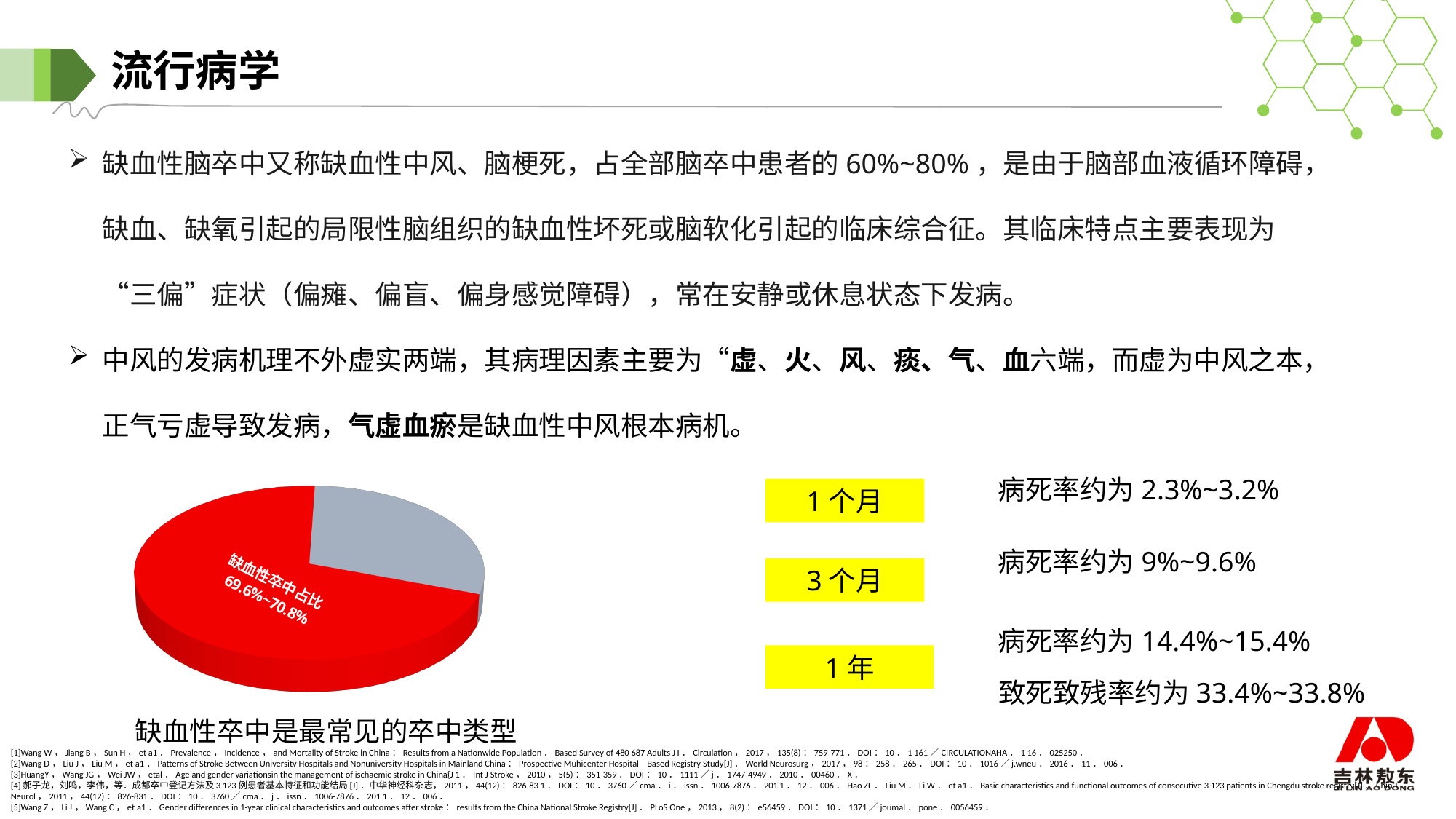
What kind of chart is shown on the slide? pie chart Is the red slice (缺血性卒中占比) larger or smaller than the grey slice? larger What is the label printed on the red slice of the pie chart? 缺血性卒中占比 69.6%~70.8% What share of the pie is labelled for 缺血性卒中占比? 69.6%~70.8% What caption is written below the pie chart? 缺血性卒中是最常见的卒中类型 What colour is the slice representing 缺血性卒中占比? red Which slice of the pie chart is the largest? 缺血性卒中占比 Is the share for 缺血性卒中占比 greater or less than 50%? greater How many slices does the pie chart have? 2